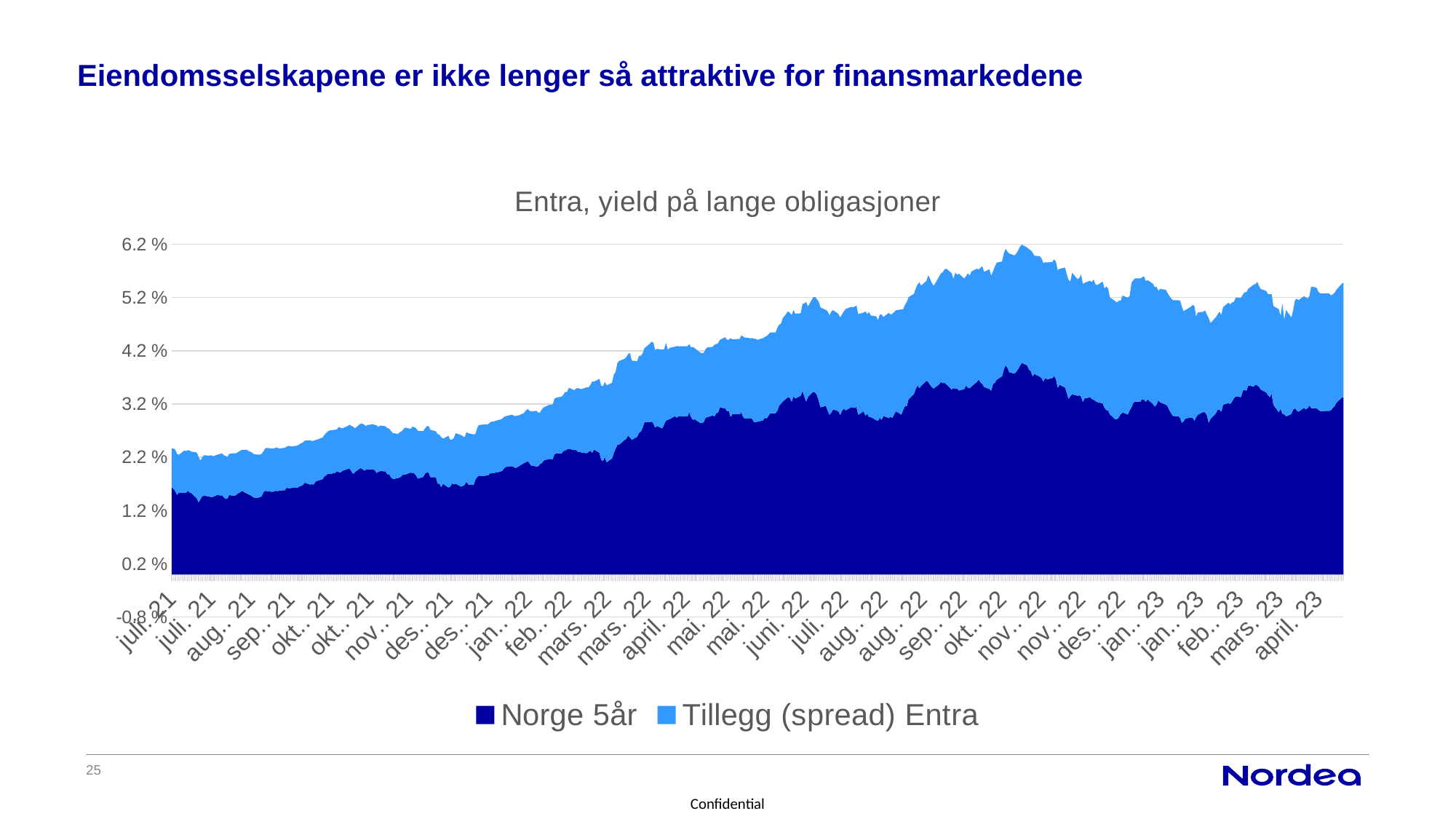
Which two series are listed in the legend? Norge 5år and Tillegg (spread) Entra Is the value for Norge 5år at the start of the chart (juli 21) greater or less than 2.2 %? less Is the total stacked yield at the end of the chart (april 23) greater or less than 4.2 %? greater What kind of chart is shown on the slide? Stacked area chart What is the title of the chart? Entra, yield på lange obligasjoner Is the peak value of Norge 5år, reached around okt./nov. 22, greater or less than 3.2 %? greater At the start of the chart (juli 21), which series contributes more to the total: Norge 5år or Tillegg (spread) Entra? Norge 5år How many series does the legend list? 2 Does the total yield generally rise or fall from juli 21 to april 23? Rise